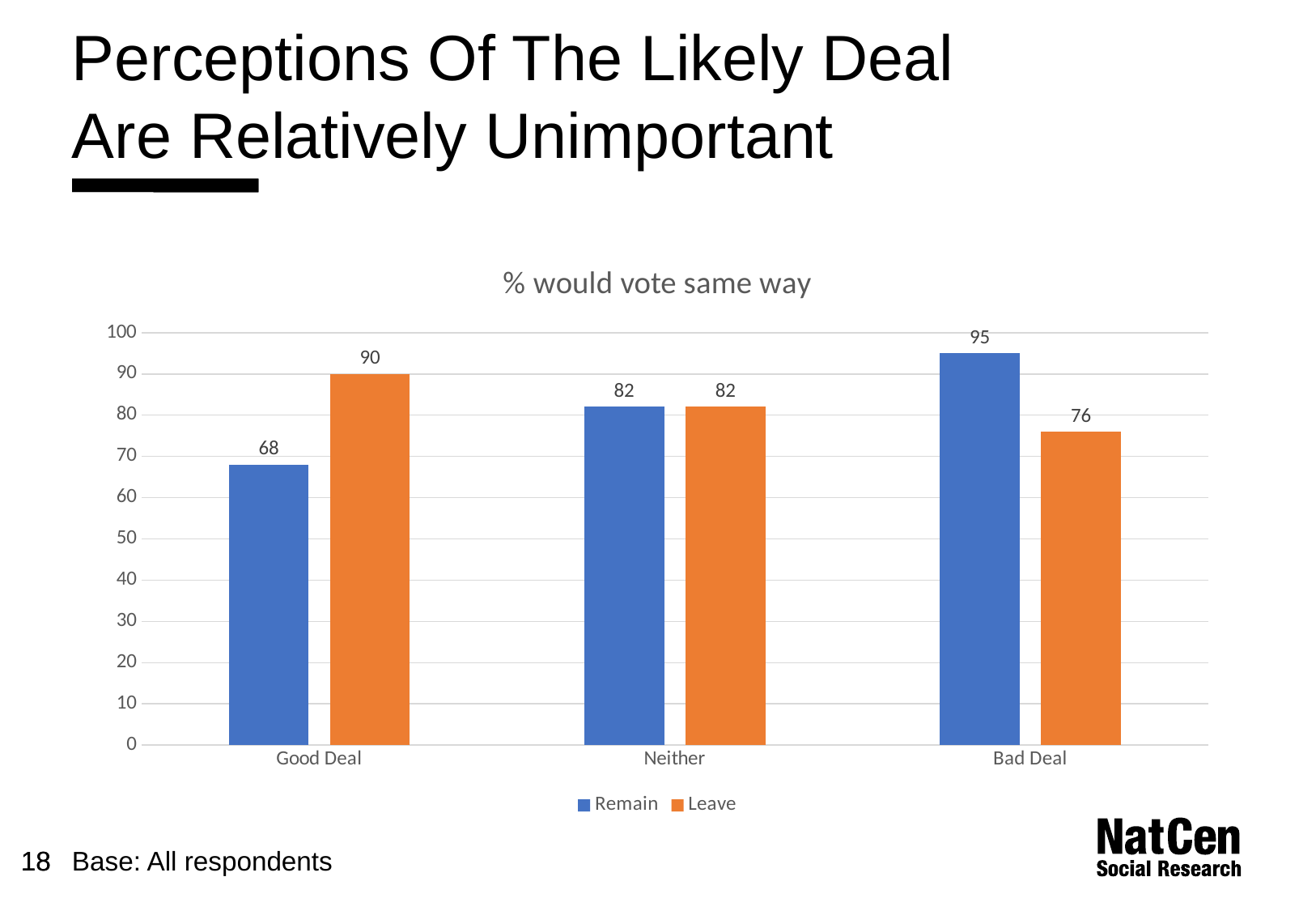
What is the Leave value for Good Deal? 90 What is the difference between the Leave and Remain values for Good Deal? 22 What is the Remain value for Good Deal? 68 How many series does the legend list? 2 What kind of chart is shown on the slide? Bar chart What is the Leave value for Bad Deal? 76 Which is larger for Bad Deal, the Remain value or the Leave value? Remain What is the title of the chart? % would vote same way Which category has the highest Remain value? Bad Deal How many categories are shown on the x axis? 3 Which category has the lowest Leave value? Bad Deal Is the Remain value for Bad Deal greater or less than 90? greater